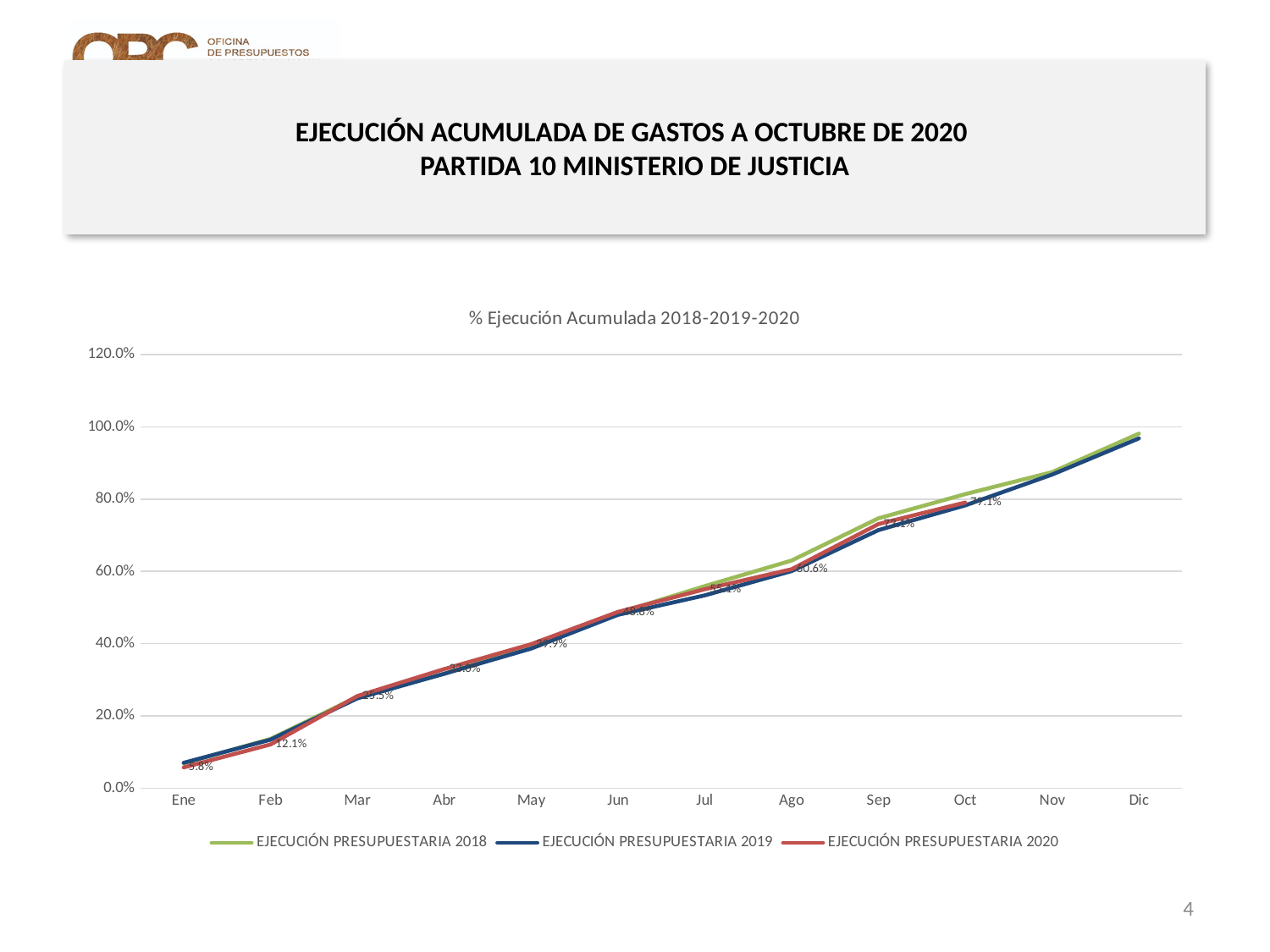
Is the value for EJECUCIÓN PRESUPUESTARIA 2019 in Jun greater or less than 40.0%? greater What kind of chart is shown on the slide? line chart How many series does the legend list? 3 How many months are shown along the x axis? 12 What is the value for EJECUCIÓN PRESUPUESTARIA 2020 in Ene? 5.8% What is the value for EJECUCIÓN PRESUPUESTARIA 2020 in Feb? 12.1% What is the value for EJECUCIÓN PRESUPUESTARIA 2020 in Ago? 60.6% What is the difference between the EJECUCIÓN PRESUPUESTARIA 2020 values for Oct and Ago? 18.5 percentage points Is the value for EJECUCIÓN PRESUPUESTARIA 2018 in Dic greater or less than 100.0%? less What is the value for EJECUCIÓN PRESUPUESTARIA 2020 in Oct? 79.1% What is the title of the chart? % Ejecución Acumulada 2018-2019-2020 Do the values of the EJECUCIÓN PRESUPUESTARIA 2020 series rise or fall from Ene to Oct? rise